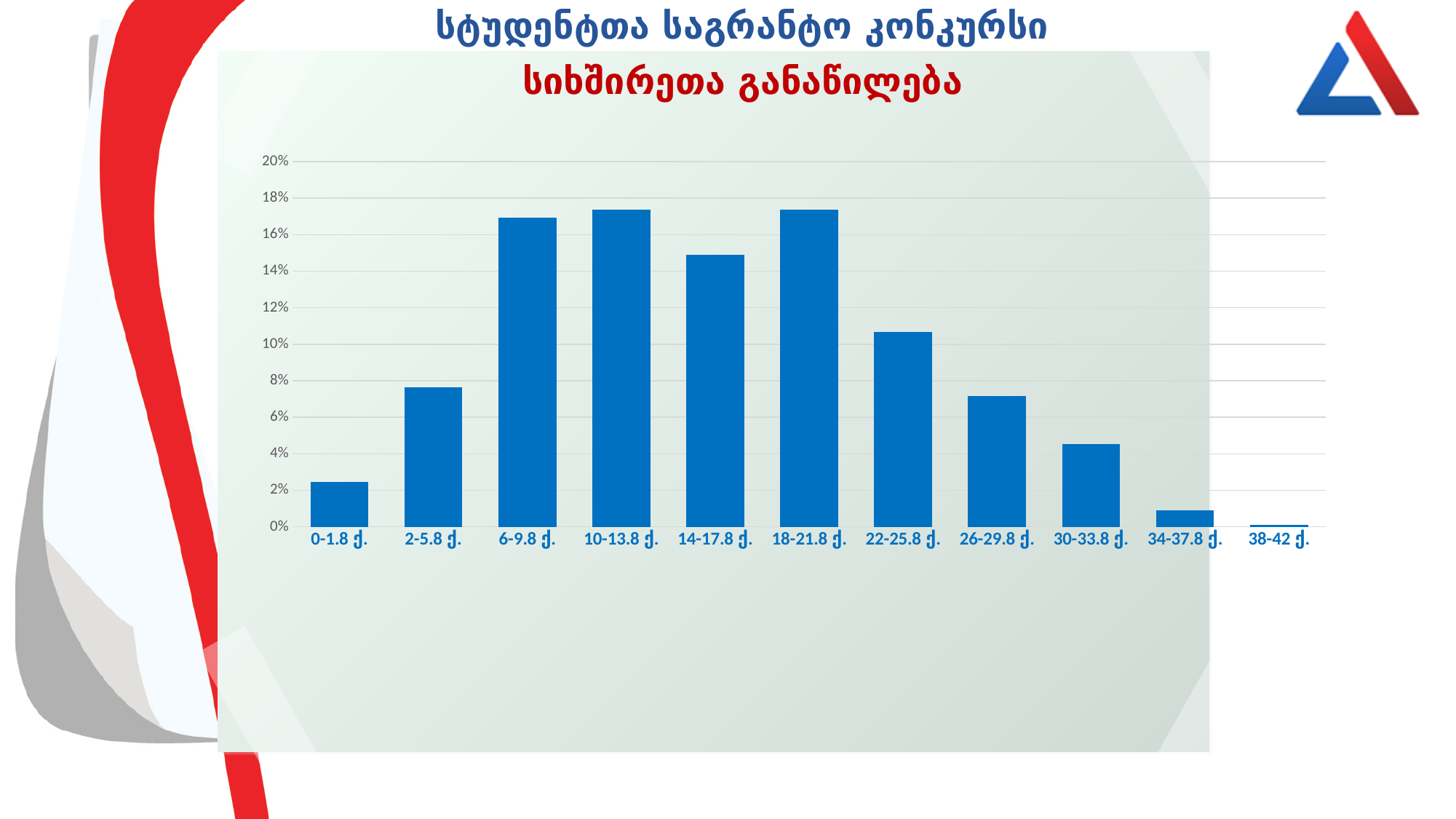
What colour are the bars in the chart? blue Which category has the lowest value in the chart? 38-42 ქ. What kind of chart is shown on the slide? bar chart Is the value for 2-5.8 ქ. greater or less than 8%? less How many categories are shown on the x axis of the chart? 11 Do the values rise or fall from 22-25.8 ქ. to 38-42 ქ. along the x axis? fall Is the value for 22-25.8 ქ. greater or less than 10%? greater Which is larger, the value for 22-25.8 ქ. or the value for 26-29.8 ქ.? 22-25.8 ქ. Which is larger, the value for 6-9.8 ქ. or the value for 14-17.8 ქ.? 6-9.8 ქ. Is the value for 34-37.8 ქ. greater or less than 2%? less